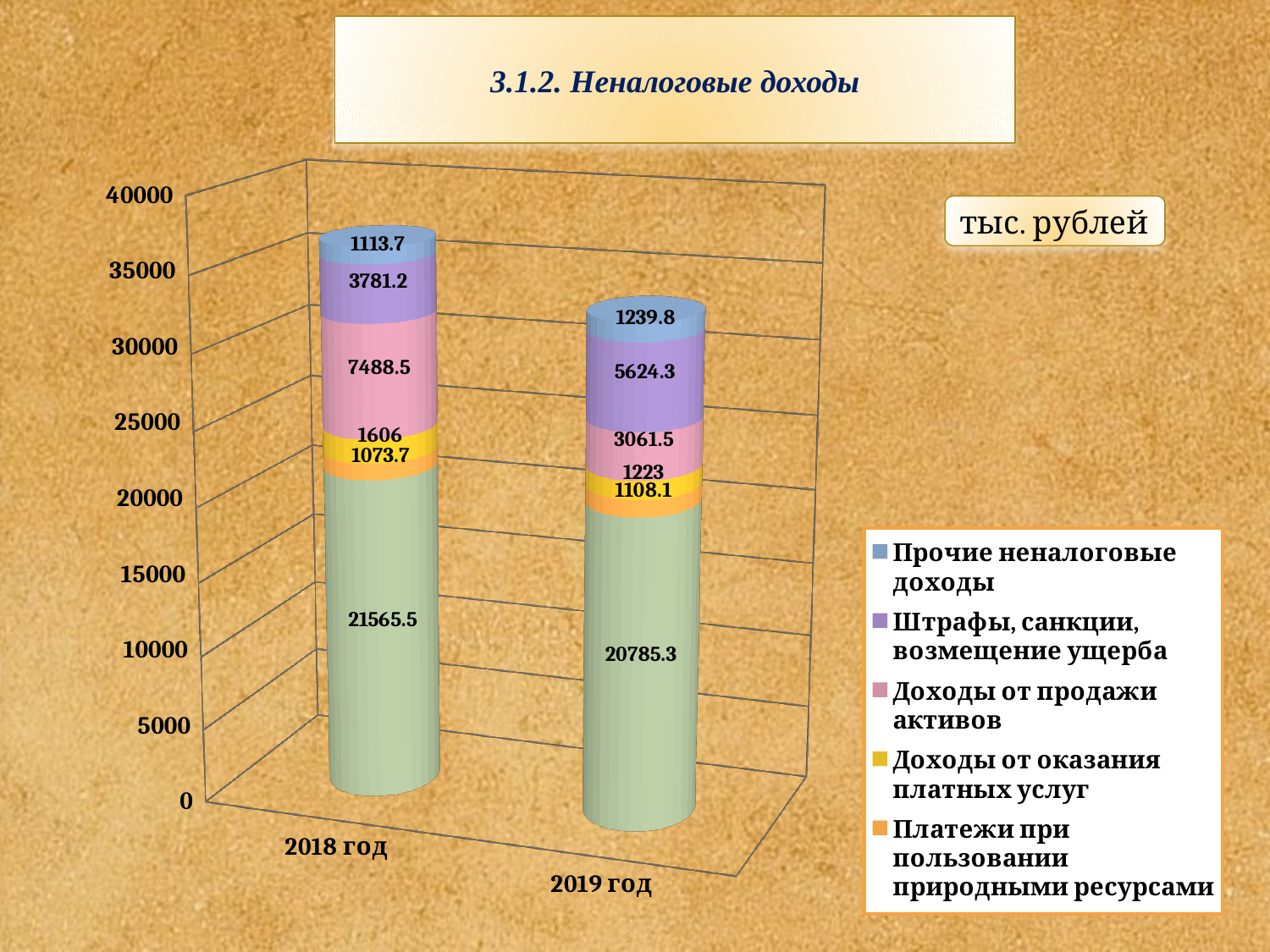
What is the difference in Доходы от продажи активов between 2018 год and 2019 год? 4427 How many categories (years) are shown on the x axis? 2 By how much did Штрафы, санкции, возмещение ущерба increase from 2018 год to 2019 год? 1843.1 What is the value for Платежи при пользовании природными ресурсами in 2018 год? 1073.7 What unit is stated for the values on the chart? тыс. рублей Which year has the larger value for Доходы от продажи активов, 2018 год or 2019 год? 2018 год What is the total of the stacked bar for 2019 год? 33042 How many series does the legend list? 5 What is the value for Прочие неналоговые доходы in 2019 год? 1239.8 What is the value for Доходы от продажи активов in 2019 год? 3061.5 What is the value for Доходы от оказания платных услуг in 2019 год? 1223 What is the value for Штрафы, санкции, возмещение ущерба in 2018 год? 3781.2